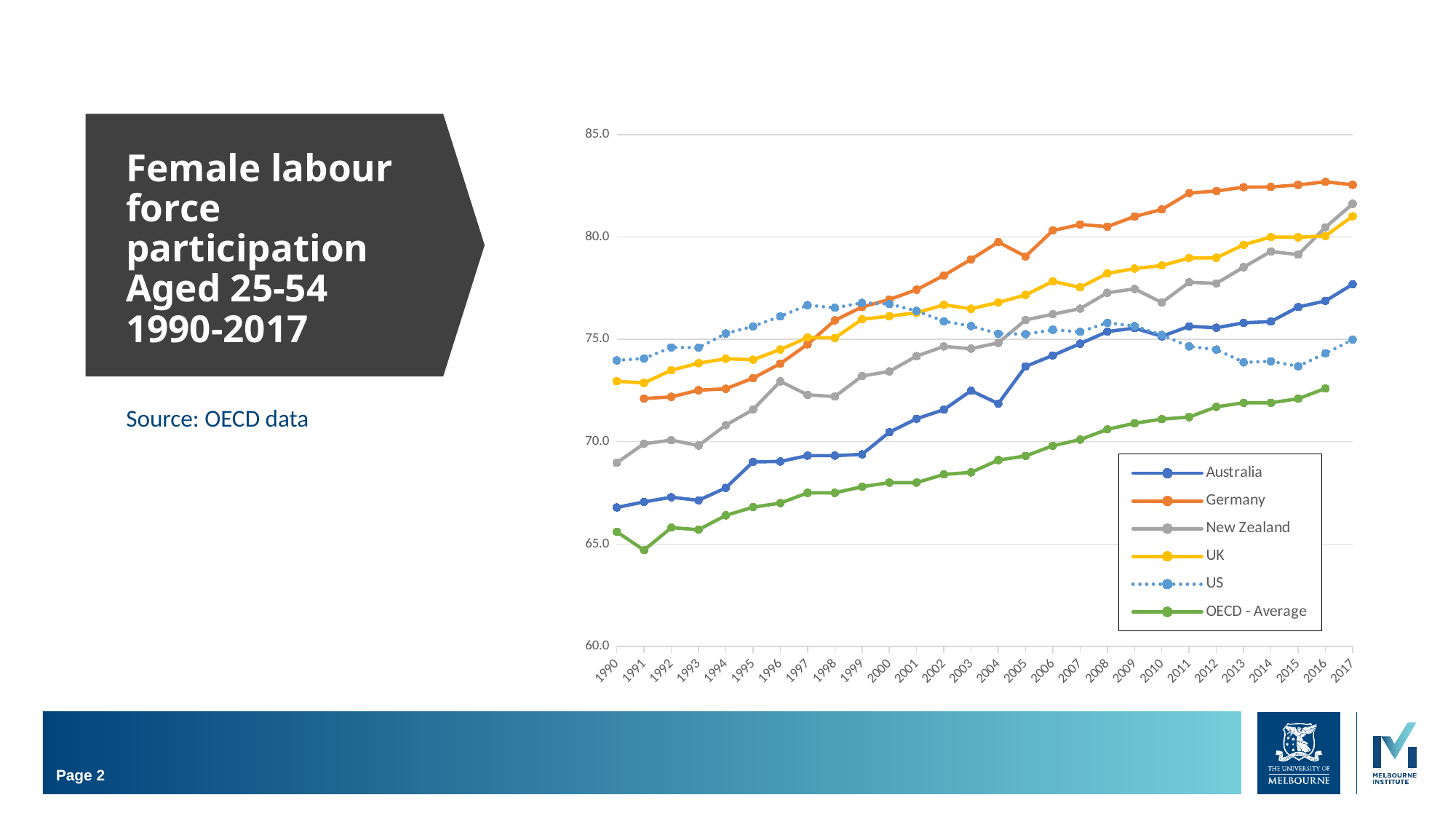
What kind of chart is shown on the slide? line chart Which series is drawn with a dotted line? US Which series has the lowest value in 2017? US How many series does the legend list? 6 Is the value for Australia in 1990 greater or less than 70? less Is the value for New Zealand in 1990 greater or less than 70? less Which series has the highest value in 2017? Germany How many years are plotted along the x axis? 28 Is the value for Germany in 2017 greater or less than 80? greater Does the Germany line rise or fall from 1990 to 2017? rise In 2017, which is larger, the value for the UK or the value for the US? UK